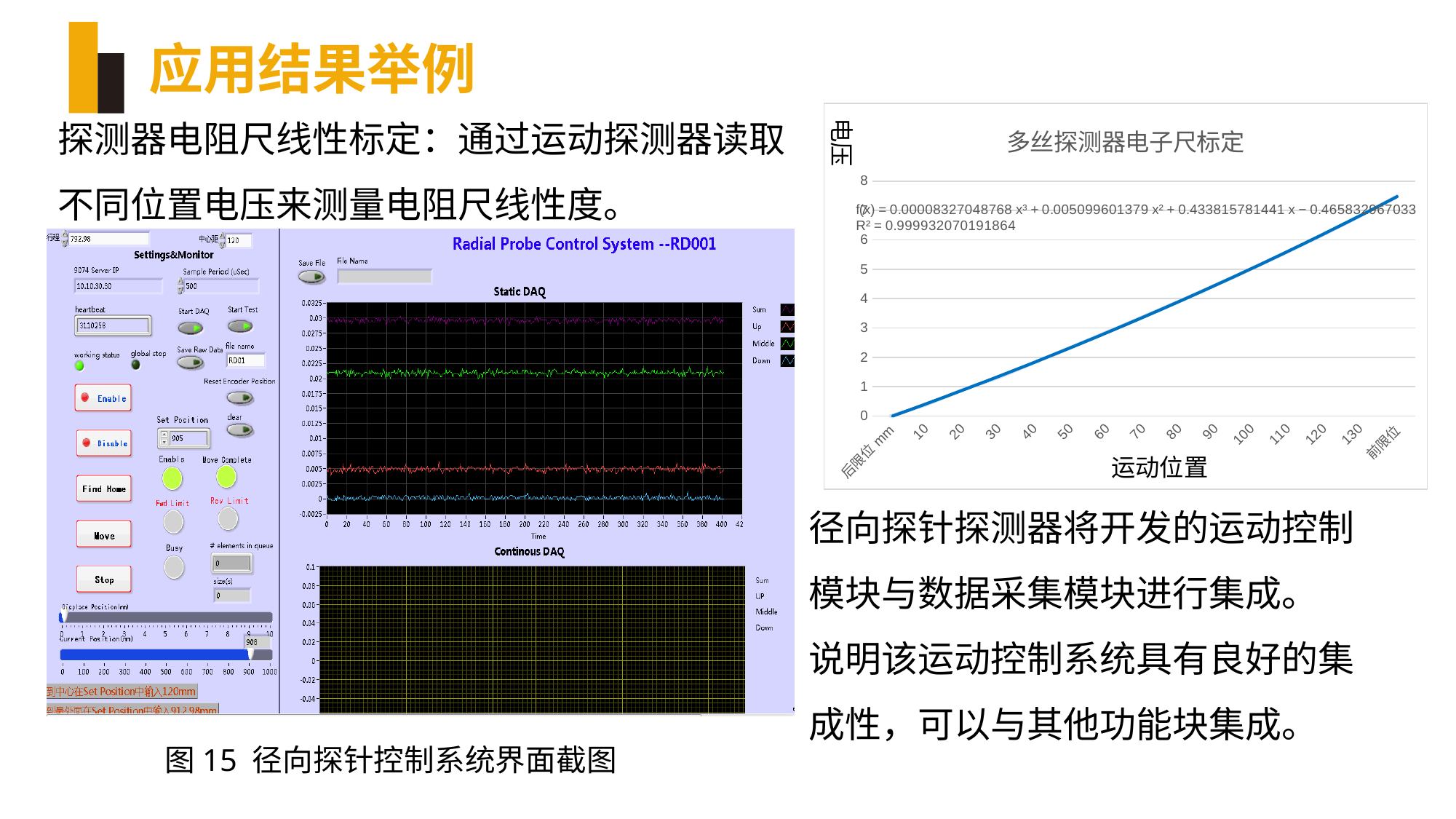
In the chart titled 多丝探测器电子尺标定, is the value at 100 greater or less than 4? greater In the chart titled 多丝探测器电子尺标定, is the value at 30 greater or less than 2? less In the chart titled 多丝探测器电子尺标定, which x-axis category has the highest value? 前限位 In the chart titled 多丝探测器电子尺标定, is the value at 120 greater or less than 5? greater In the chart titled 多丝探测器电子尺标定, do the values rise or fall as the x axis moves from 后限位 mm to 前限位? rise In the chart titled 多丝探测器电子尺标定, which x-axis category has the lowest value? 后限位 mm What is the R² value printed on the chart titled 多丝探测器电子尺标定? 0.999932070191864 How many categories are labelled on the x axis of the chart titled 多丝探测器电子尺标定? 15 What kind of chart is the chart titled 多丝探测器电子尺标定? line chart In the chart titled 多丝探测器电子尺标定, which has the larger value, 100 or 50? 100